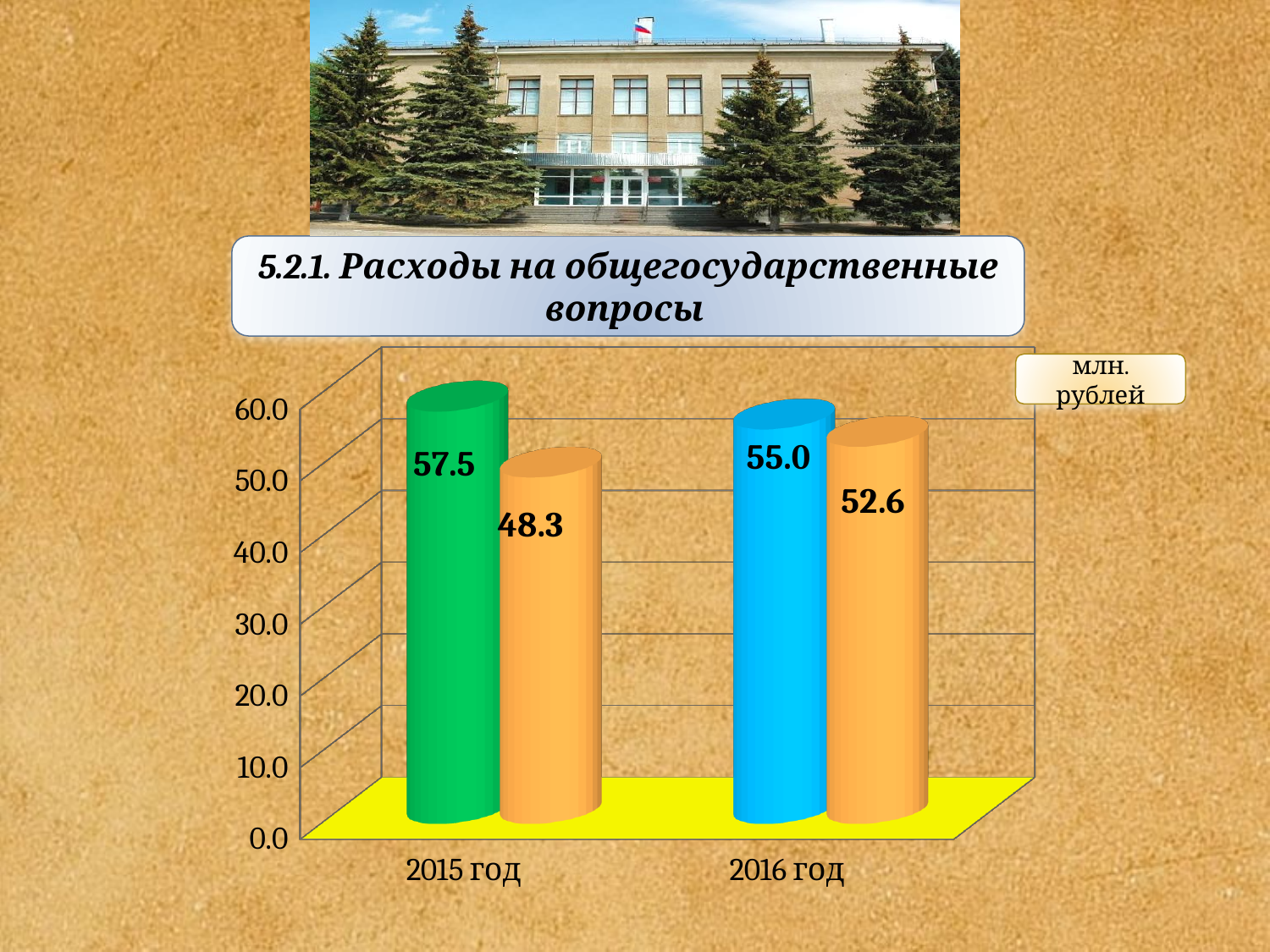
What type of chart is shown on the slide? Bar chart What unit of measurement is indicated for the chart values? млн. рублей Which bar on the chart has the lowest value? The orange bar for 2015 год (48.3) What is the value of the green bar for 2015 год? 57.5 How many year categories are shown on the x axis? 2 Which is larger: the green bar for 2015 год or the blue bar for 2016 год? The green bar for 2015 год Which bar on the chart has the highest value? The green bar for 2015 год (57.5) What is the difference between the two bars for 2015 год? 9.2 What is the difference between the orange bar for 2016 год and the orange bar for 2015 год? 4.3 What is the value of the orange bar for 2015 год? 48.3 What is the value of the orange bar for 2016 год? 52.6 What is the value of the blue bar for 2016 год? 55.0